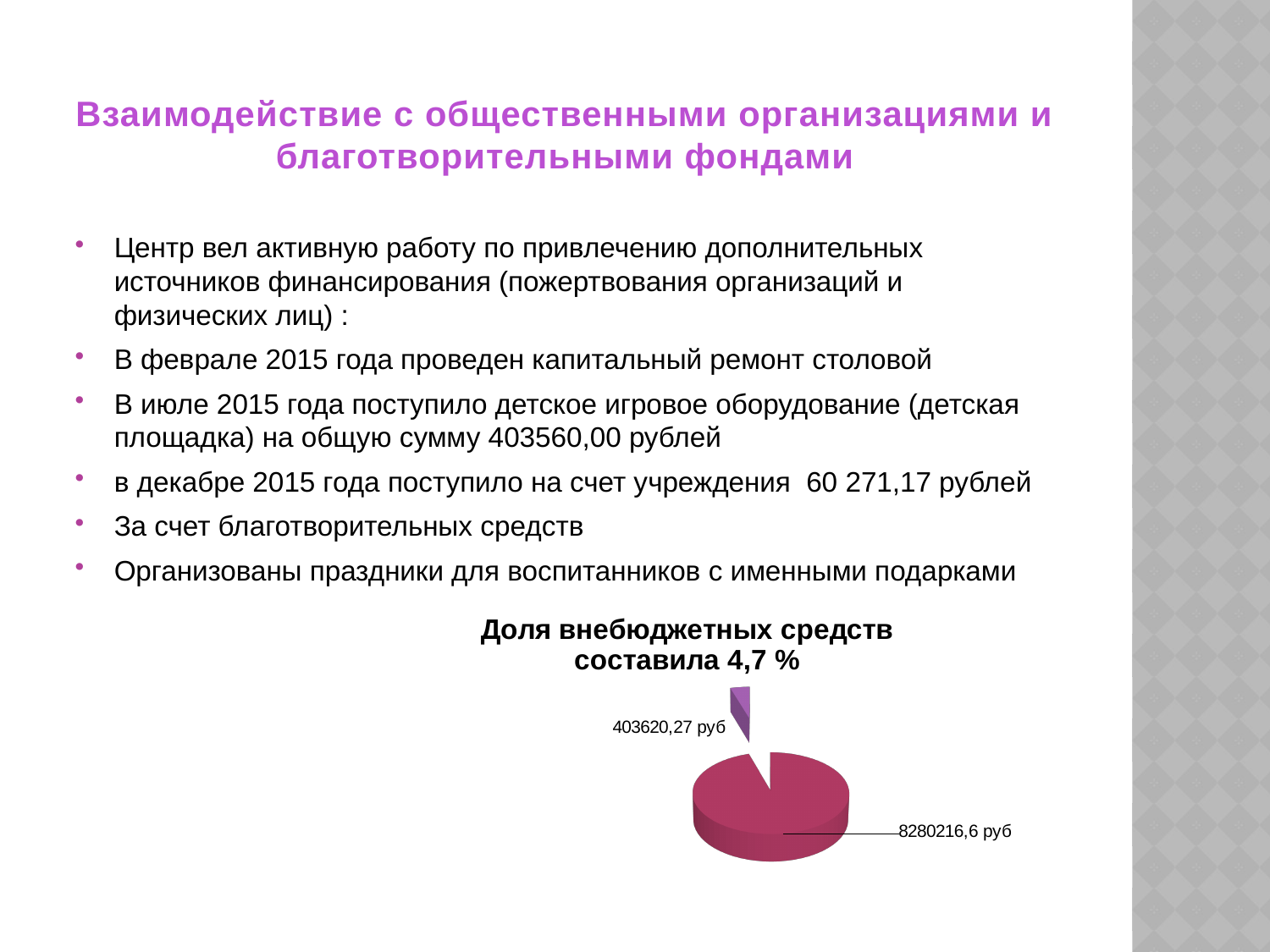
According to the chart title, what share of the total do the extra-budgetary funds (внебюджетные средства) make up? 4,7 % What value is labelled on the large magenta slice of the pie chart? 8280216,6 руб How many slices does the pie chart have? 2 What kind of chart is shown on the slide? pie chart What colour is the small slice of the pie chart? purple Which slice of the pie chart is the smallest? 403620,27 руб What is the title of the pie chart? Доля внебюджетных средств составила 4,7 % Which is larger in the pie chart: the slice labelled 403620,27 руб or the slice labelled 8280216,6 руб? 8280216,6 руб Which slice of the pie chart is the largest? 8280216,6 руб What is the difference between the two slice values in the pie chart? 7876596,33 руб What value is labelled on the small purple slice of the pie chart? 403620,27 руб